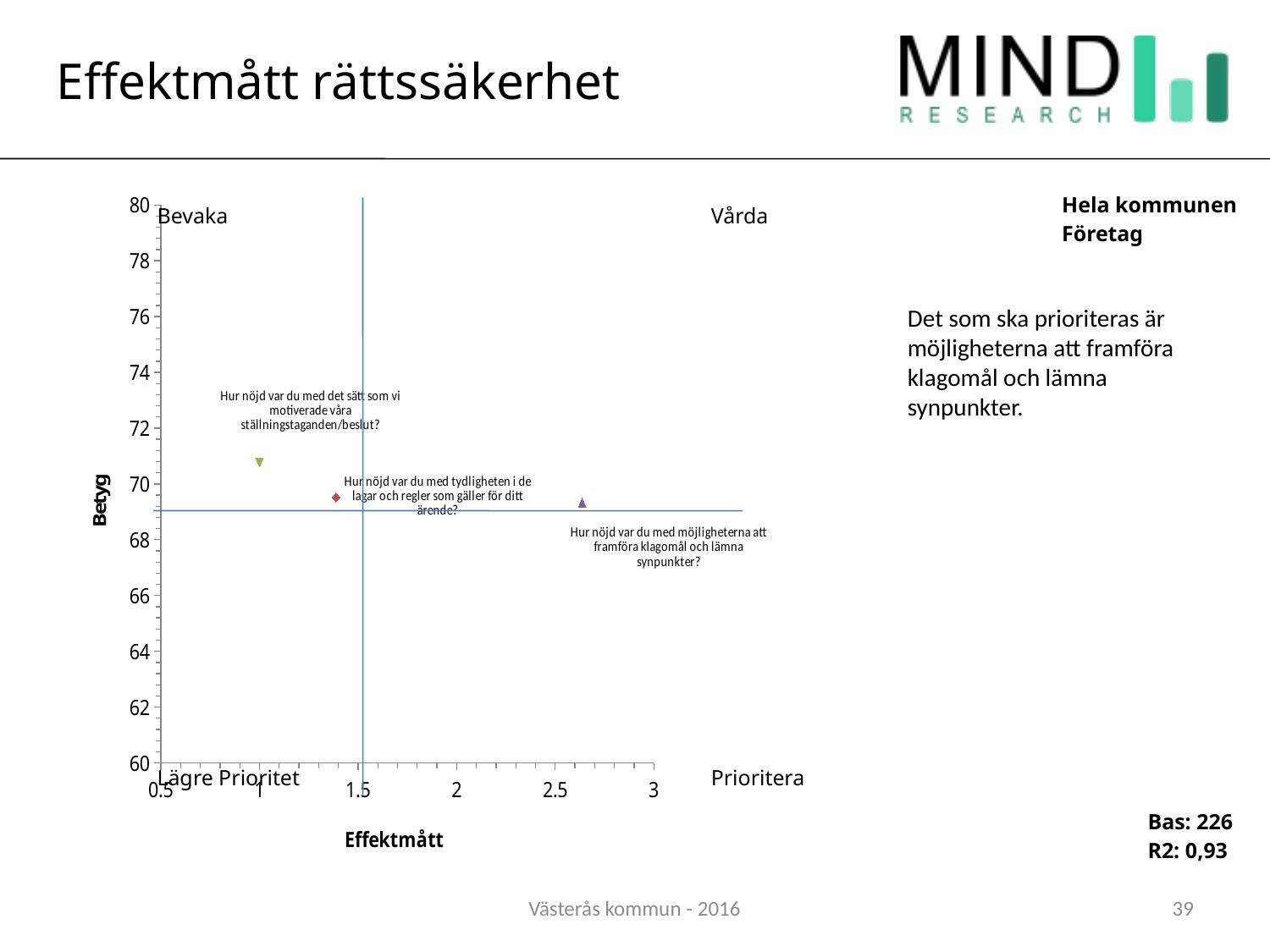
How many data points are plotted on the chart? 3 Which question has the highest Effektmått (x-axis) value? Hur nöjd var du med möjligheterna att framföra klagomål och lämna synpunkter? Is the Effektmått value for 'Hur nöjd var du med möjligheterna att framföra klagomål och lämna synpunkter?' greater or less than 2.5? greater Which question has the lowest Effektmått (x-axis) value? Hur nöjd var du med det sätt som vi motiverade våra ställningstaganden/beslut? Which question has the highest Betyg (y-axis) value? Hur nöjd var du med det sätt som vi motiverade våra ställningstaganden/beslut? What kind of chart is shown on the slide? Scatter chart What is the title of the x-axis? Effektmått Is the Betyg value for 'Hur nöjd var du med möjligheterna att framföra klagomål och lämna synpunkter?' greater or less than 70? less What is the title of the y-axis? Betyg Which has the larger Effektmått value: 'Hur nöjd var du med tydligheten i de lagar och regler som gäller för ditt ärende?' or 'Hur nöjd var du med möjligheterna att framföra klagomål och lämna synpunkter?' Hur nöjd var du med möjligheterna att framföra klagomål och lämna synpunkter? Is the Betyg value for 'Hur nöjd var du med det sätt som vi motiverade våra ställningstaganden/beslut?' greater or less than 70? greater